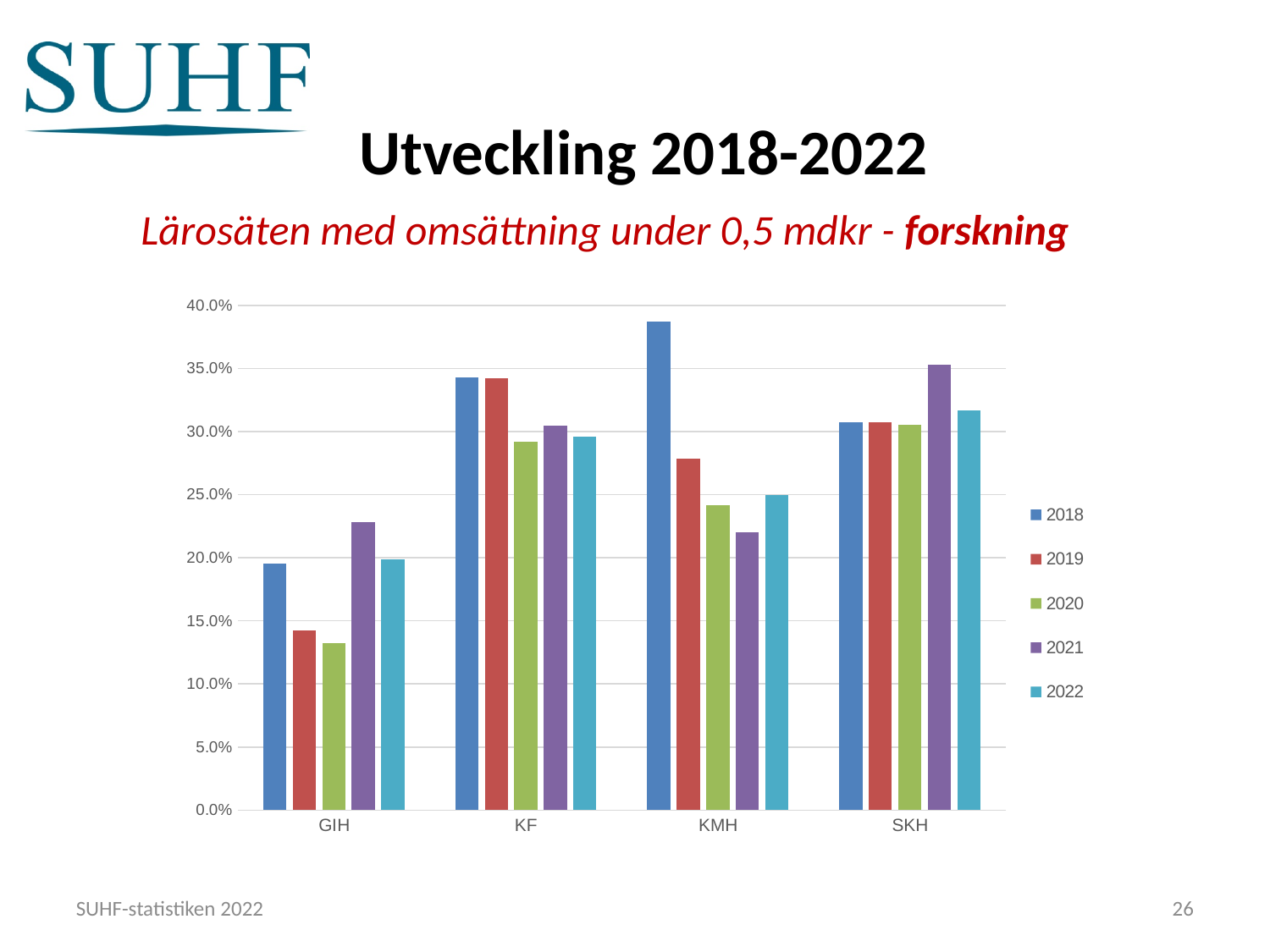
Is the 2018 value for KMH greater or less than 35.0%? greater Which institution has the highest value for 2018? KMH What kind of chart is shown on the slide? bar chart Is the 2020 value for GIH greater or less than 15.0%? less For KMH, which year has the larger value, 2019 or 2021? 2019 How many series does the chart's legend list? 5 Which years are listed in the chart's legend? 2018, 2019, 2020, 2021, 2022 Is the 2021 value for KMH greater or less than 25.0%? less How many institutions (categories) are shown on the x axis of the chart? 4 Which institution has the lowest value for 2020? GIH For KMH, do the values rise or fall from 2018 to 2021? fall For GIH, which year has the larger value, 2021 or 2022? 2021